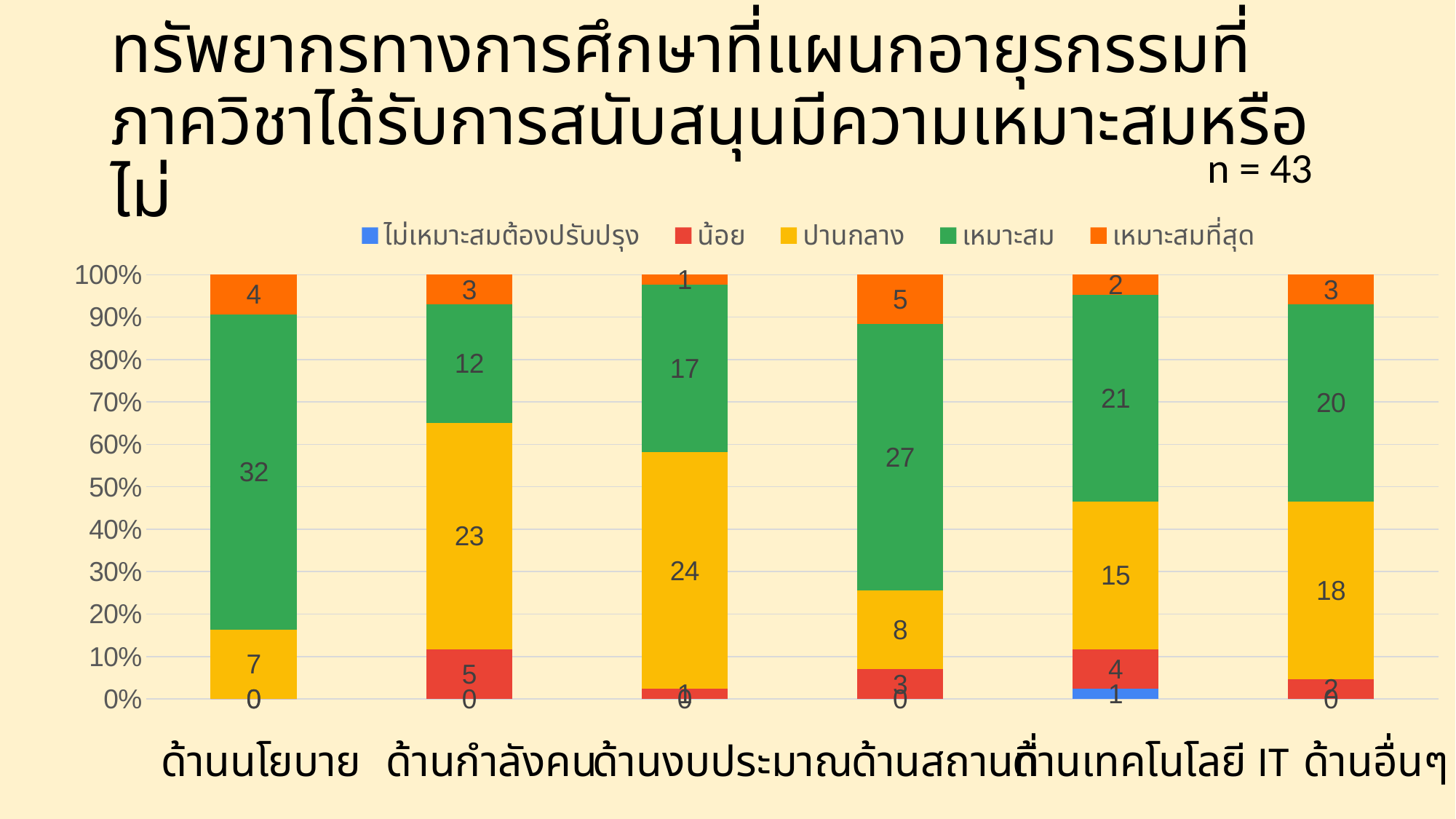
What is the value of เหมาะสม for ด้านนโยบาย? 32 Which category has the lowest value for ปานกลาง? ด้านนโยบาย What is the value of น้อย for ด้านเทคโนโลยี IT? 4 What is the total of the stacked bar for ด้านเทคโนโลยี IT? 43 How many series does the legend list? 5 How many categories are shown along the x axis? 6 What is the difference between the ปานกลาง values for ด้านงบประมาณ and ด้านอื่นๆ? 6 Which is larger: the เหมาะสม value for ด้านกำลังคน or for ด้านอื่นๆ? ด้านอื่นๆ Which category has the highest value for เหมาะสม? ด้านนโยบาย What is the value of ปานกลาง for ด้านกำลังคน? 23 What is the value of เหมาะสมที่สุด for ด้านงบประมาณ? 1 What kind of chart is shown on the slide? stacked bar chart